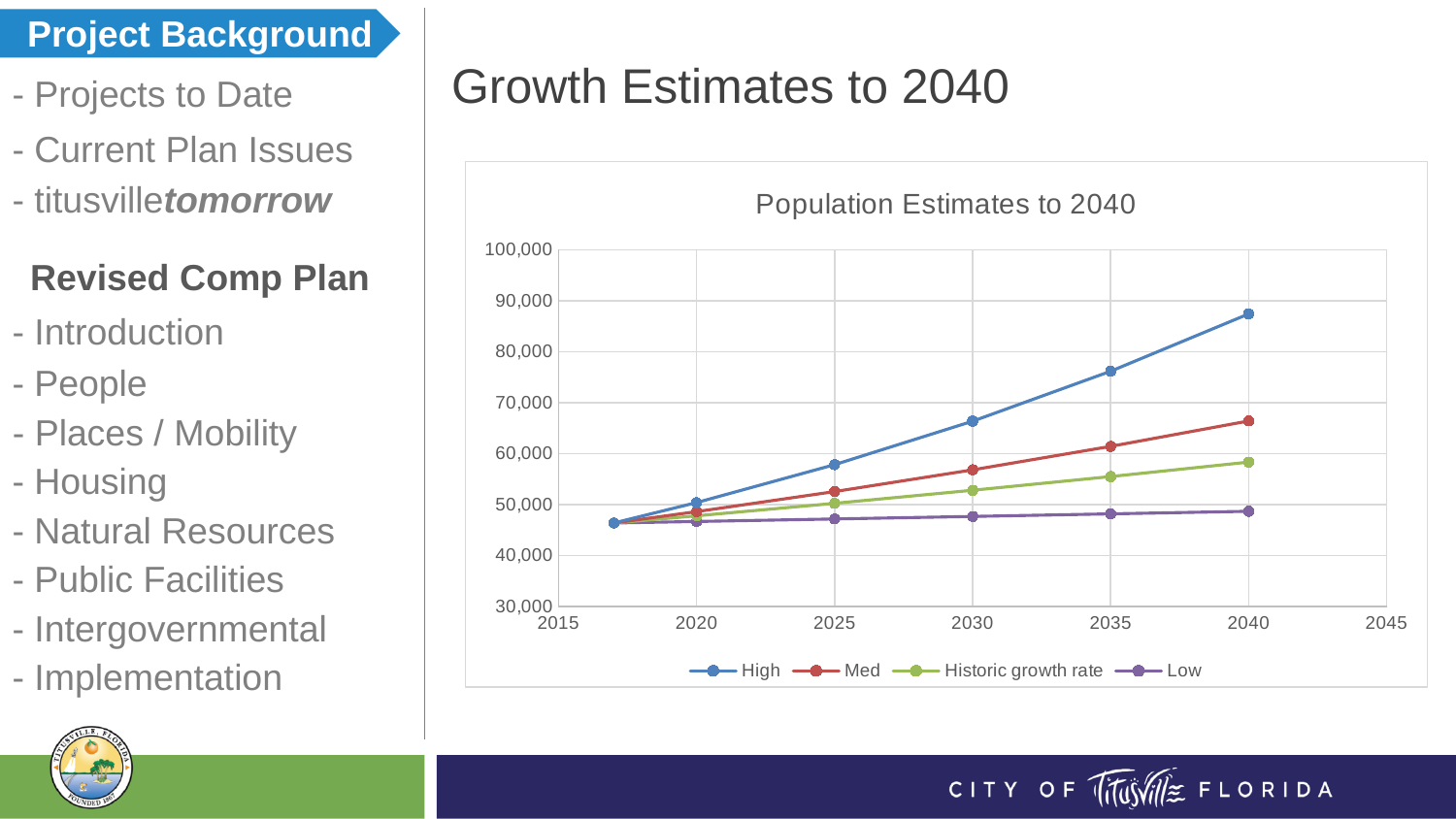
Is the value for the High series in 2040 greater or less than 80,000? greater Does the High series rise or fall from 2017 to 2040? Rises Which series is lowest in 2040? Low How many series does the chart legend list? 4 Is the value for the Med series in 2040 greater or less than 60,000? greater What is the title of the chart? Population Estimates to 2040 Which series is highest in 2040? High What kind of chart is shown on the slide? Line chart Is the value for the High series in 2035 greater or less than 70,000? greater Which series is plotted in purple? Low In 2040, which is larger: the Med series or the Historic growth rate series? Med